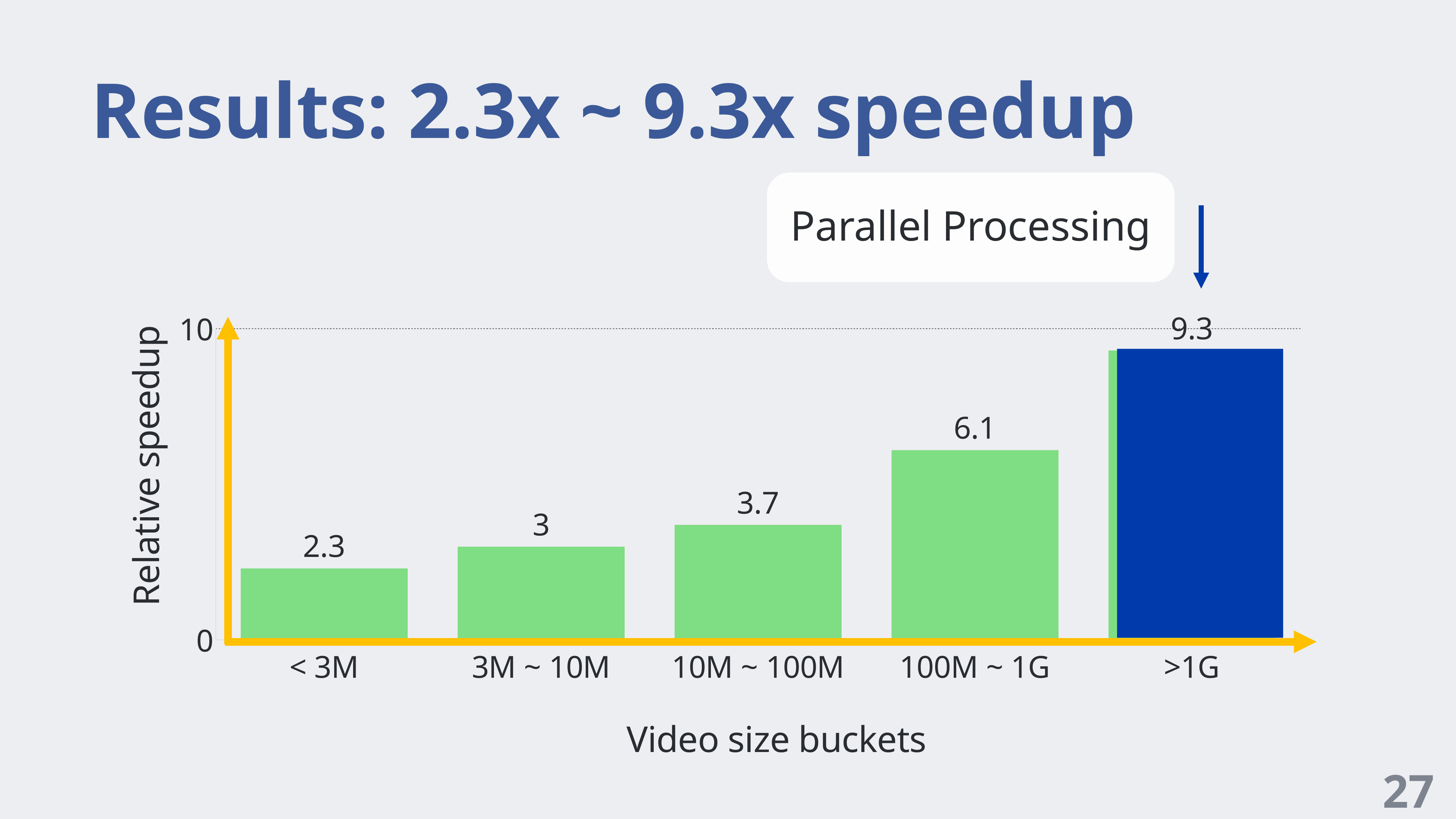
What kind of chart is shown on the slide? Bar chart What is the relative speedup for the < 3M video size bucket? 2.3 Which video size bucket has the lowest relative speedup? < 3M How many video size buckets are shown in the chart? 5 What is the relative speedup for the 100M ~ 1G bucket? 6.1 What is the difference in relative speedup between the 100M ~ 1G bucket and the 3M ~ 10M bucket? 3.1 What is the difference in relative speedup between the >1G bucket and the < 3M bucket? 7 Which video size bucket has the highest relative speedup? >1G Which has a larger relative speedup, the 3M ~ 10M bucket or the 10M ~ 100M bucket? 10M ~ 100M What is the relative speedup for the 10M ~ 100M bucket? 3.7 Do the relative speedup values rise or fall as video size increases along the x axis? Rise What is the label on the y axis of the chart? Relative speedup